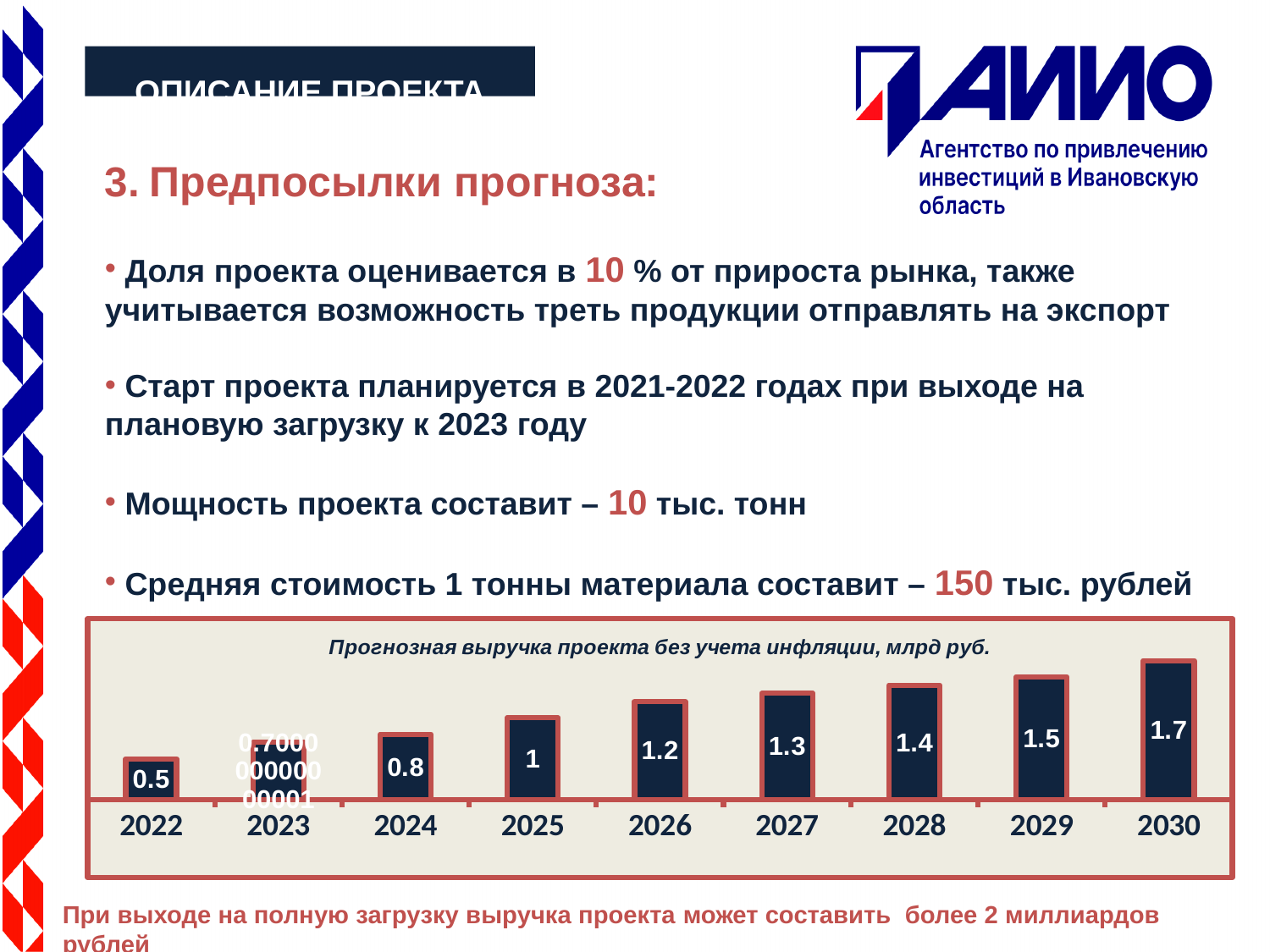
What is the difference between the values for 2028 and 2024? 0.6 What is the difference between the values for 2030 and 2022? 1.2 Do the values rise or fall from 2022 to 2030? rise What kind of chart is shown on the slide? bar chart What is the forecast revenue for 2030 in the chart? 1.7 How many years are shown on the x axis of the chart? 9 What is the forecast revenue for 2022 in the chart? 0.5 Which year has the lowest forecast revenue in the chart? 2022 Which year has the highest forecast revenue in the chart? 2030 Which year has the larger value, 2025 or 2027? 2027 What value is shown for 2028 in the chart? 1.4 What value is shown for 2026 in the chart? 1.2